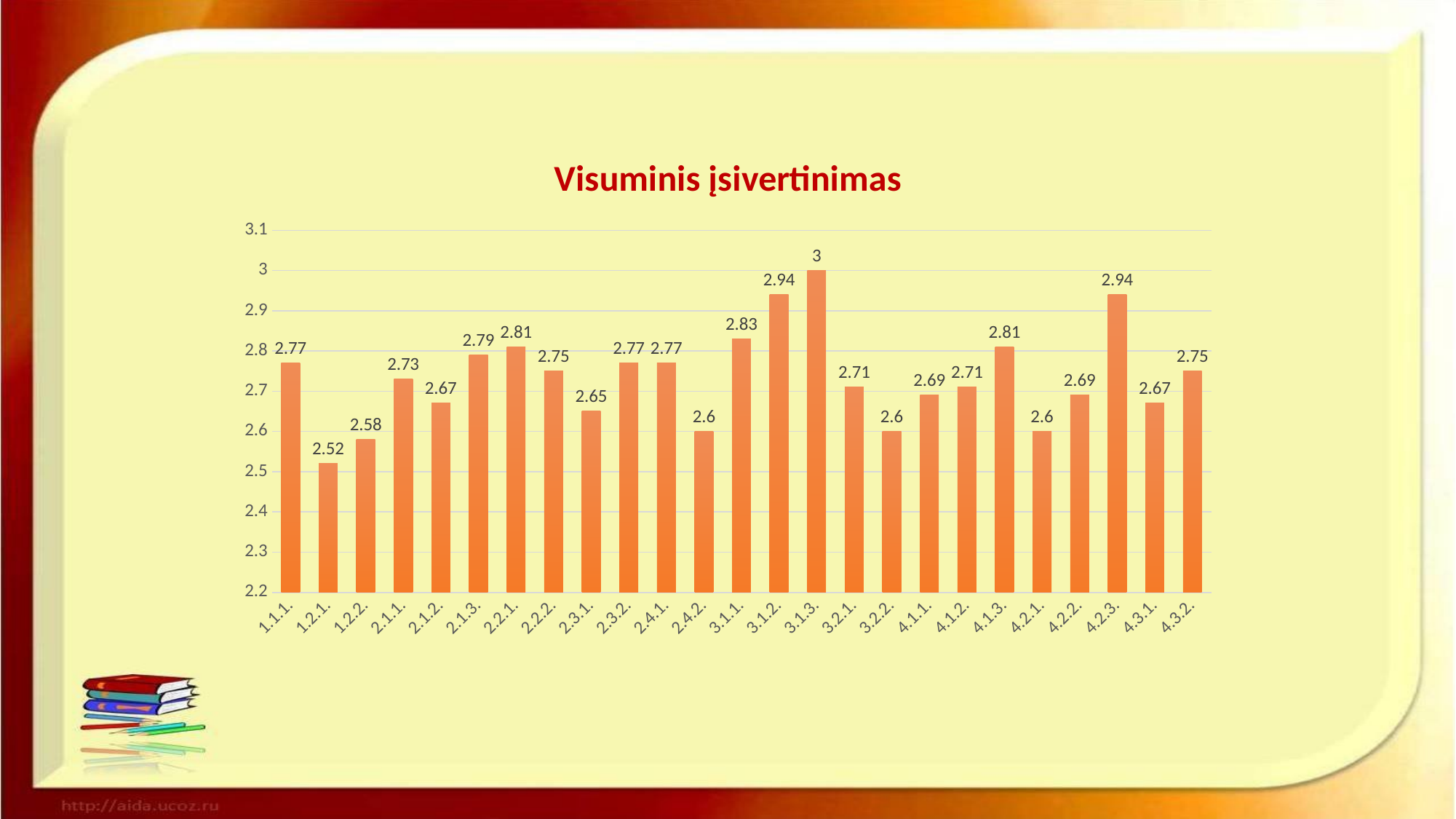
What is the value for category 3.1.3.? 3 What is the difference between the values for 3.1.3. and 1.2.1.? 0.48 Which is larger, the value for 3.1.1. or the value for 2.3.1.? 3.1.1. What is the title of the chart? Visuminis įsivertinimas What is the value for category 4.3.2.? 2.75 How many categories are shown on the x axis of the chart? 25 Which category has the highest value? 3.1.3. What kind of chart is shown on the slide? bar chart What is the value for category 4.2.3.? 2.94 What is the difference between the values for 3.1.2. and 3.2.1.? 0.23 Which category has the lowest value? 1.2.1. What is the value for category 1.2.1.? 2.52